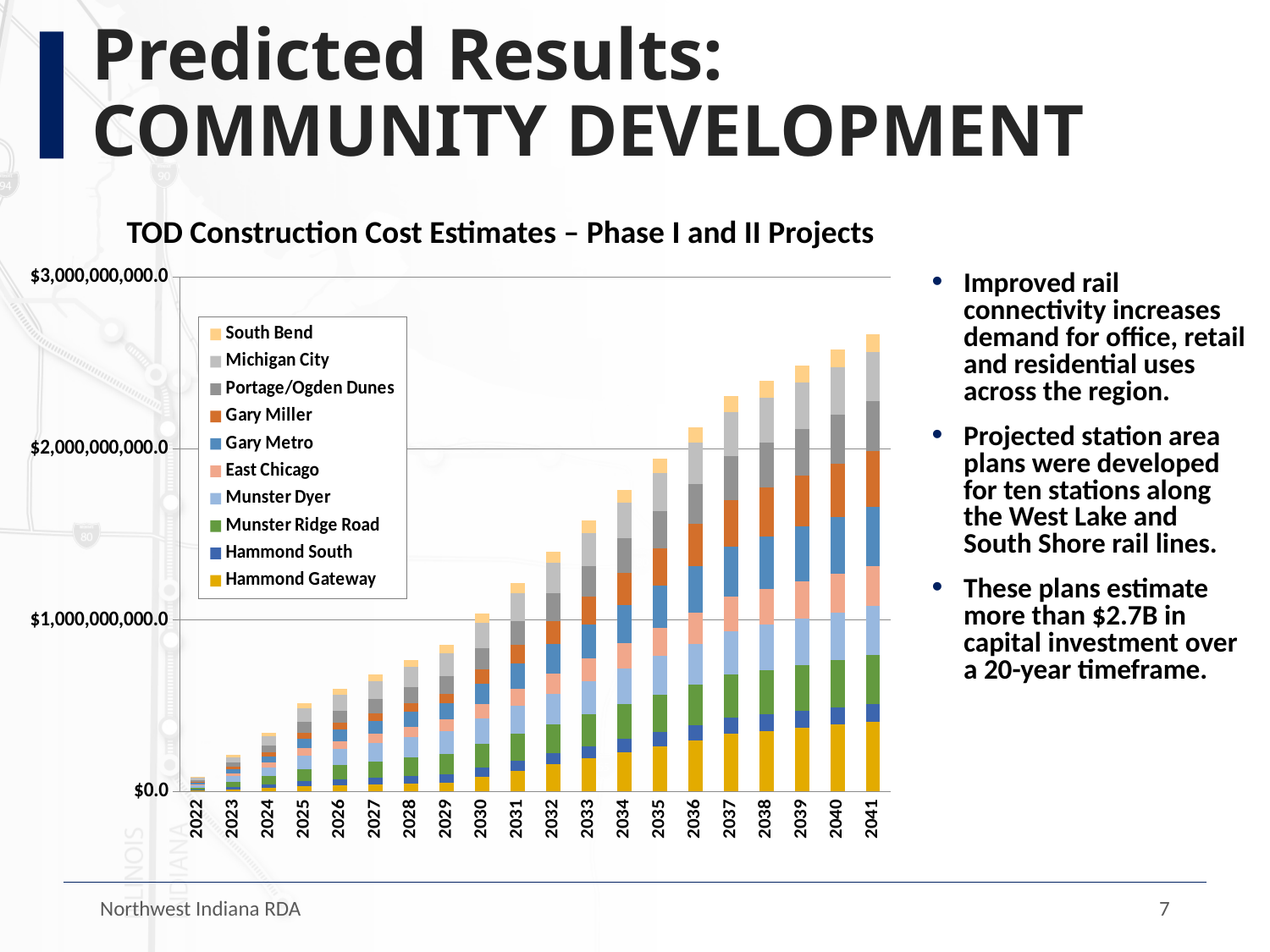
Which series is shown at the bottom of each stacked bar in yellow? Hammond Gateway How many years are shown along the x axis of the chart? 20 Which year has the shortest stacked bar? 2022 How many series does the chart legend list? 10 Is the total stacked bar for 2035 greater or less than $2,000,000,000.0? less What kind of chart is shown on the slide? Stacked bar chart Do the stacked bar totals rise or fall from 2022 to 2041? Rise What is the title of the chart? TOD Construction Cost Estimates – Phase I and II Projects Is the total stacked bar for 2029 greater or less than $1,000,000,000.0? less Is the total stacked bar for 2041 greater or less than $2,000,000,000.0? greater Which year has the larger stacked bar total, 2025 or 2038? 2038 Which year has the tallest stacked bar? 2041